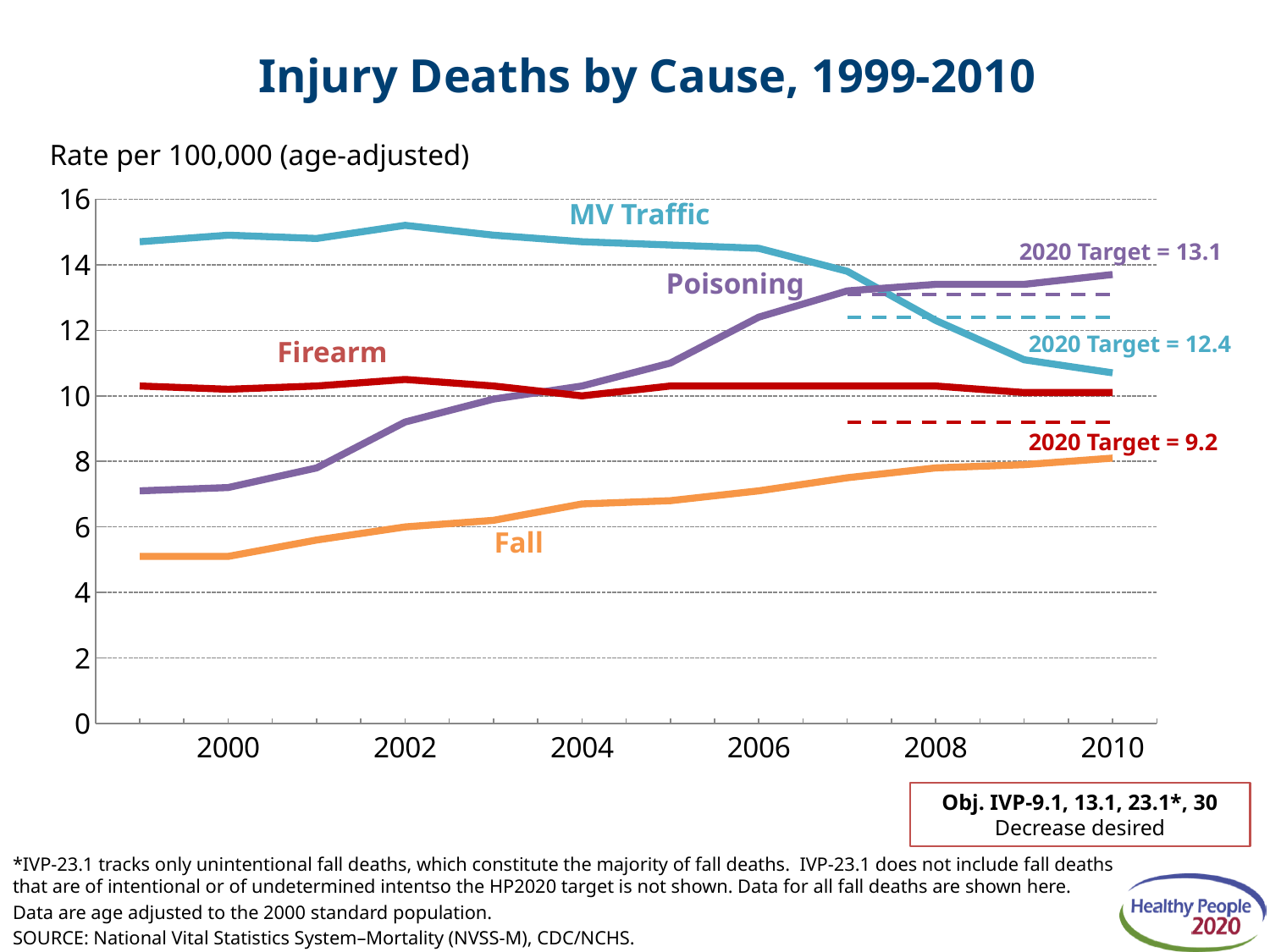
What is the 2020 target shown for MV Traffic? 12.4 In 2010, which is higher, the Poisoning rate or the MV Traffic rate? Poisoning Does the Fall death rate rise or fall from 1999 to 2010? Rises What is the 2020 target shown for Poisoning? 13.1 How many causes of injury death are plotted as lines on the chart? 4 Is the MV Traffic rate in 2010 greater or less than 12? less Which cause had the highest death rate in 1999? MV Traffic What is the 2020 target shown for Firearm? 9.2 Which cause had the lowest death rate in 1999? Fall What is the title of the chart? Injury Deaths by Cause, 1999-2010 What kind of chart is shown on the slide? Line chart Is the Fall rate in 1999 greater or less than 6? less